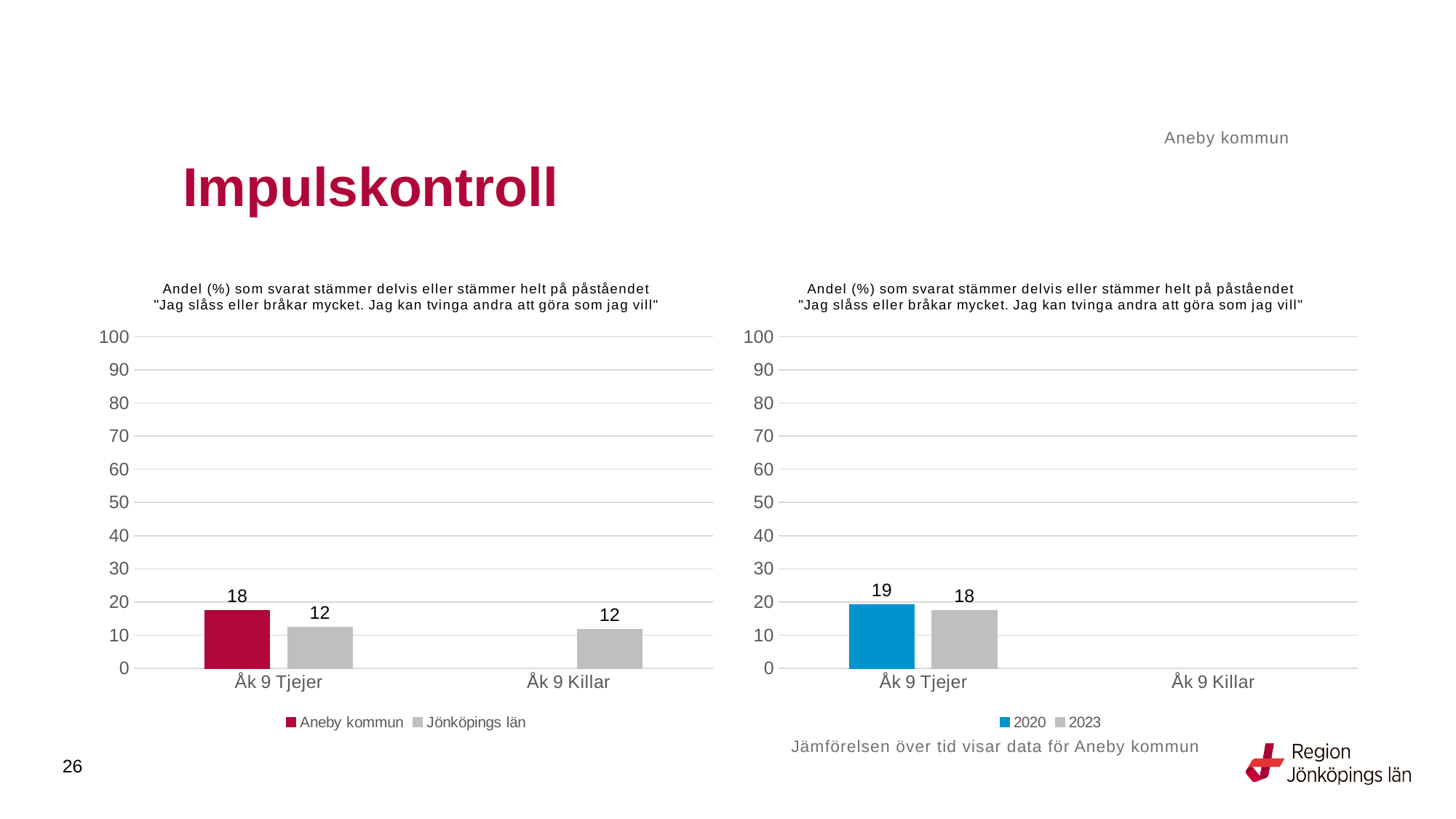
In the left chart, how many series does the legend list? 2 What kind of chart is the right chart? bar chart In the right chart, what is the value for 2023 for Åk 9 Tjejer? 18 In the left chart, which is larger for Åk 9 Tjejer, Aneby kommun or Jönköpings län? Aneby kommun In the left chart, what is the difference between Aneby kommun and Jönköpings län for Åk 9 Tjejer? 6 In the left chart, what is the value for Jönköpings län for Åk 9 Tjejer? 12 In the right chart, what is the difference between the 2020 and 2023 values for Åk 9 Tjejer? 1 In the right chart, is the value for 2020 for Åk 9 Tjejer greater or less than 30? less In the right chart, what colour is the bar for 2020? blue In the left chart, what is the value for Jönköpings län for Åk 9 Killar? 12 In the left chart, what is the value for Aneby kommun for Åk 9 Tjejer? 18 In the right chart, what is the value for 2020 for Åk 9 Tjejer? 19